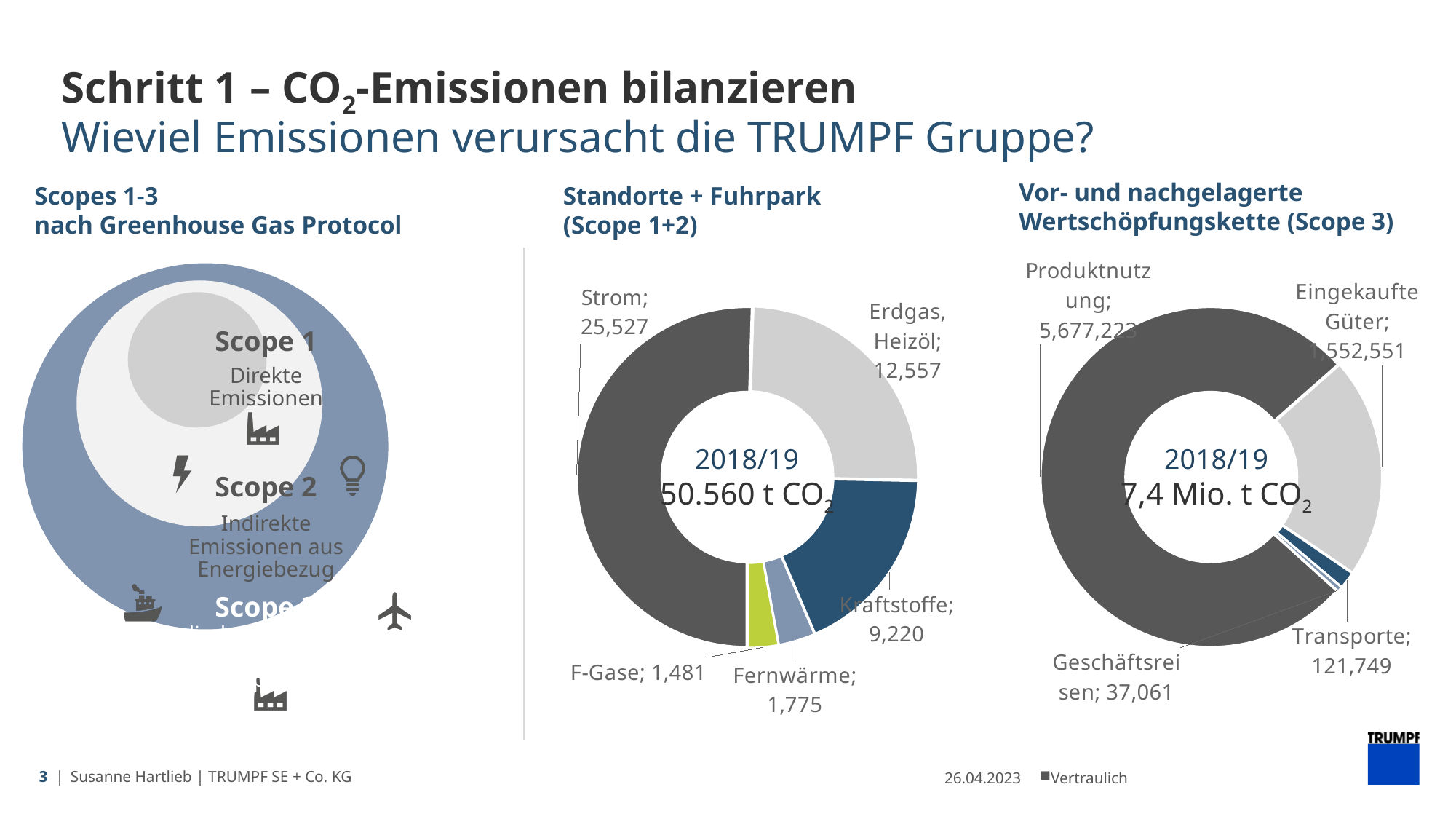
In the Vor- und nachgelagerte Wertschöpfungskette (Scope 3) chart, what is the value for Transporte? 121,749 In the Standorte + Fuhrpark (Scope 1+2) chart, what is the difference between Erdgas, Heizöl and Kraftstoffe? 3,337 In the Standorte + Fuhrpark (Scope 1+2) chart, what is the value for Strom? 25,527 In the Standorte + Fuhrpark (Scope 1+2) chart, what is the value for F-Gase? 1,481 In the Standorte + Fuhrpark (Scope 1+2) chart, what is the value for Kraftstoffe? 9,220 What kind of chart is the Standorte + Fuhrpark (Scope 1+2) chart? Donut (pie) chart How many categories are shown in the Standorte + Fuhrpark (Scope 1+2) chart? 5 In the Standorte + Fuhrpark (Scope 1+2) chart, which category has the largest value? Strom In the Vor- und nachgelagerte Wertschöpfungskette (Scope 3) chart, what is the value for Geschäftsreisen? 37,061 In the Standorte + Fuhrpark (Scope 1+2) chart, which category has the smallest value? F-Gase In the Vor- und nachgelagerte Wertschöpfungskette (Scope 3) chart, which category has the largest value? Produktnutzung In the Vor- und nachgelagerte Wertschöpfungskette (Scope 3) chart, what is the difference between Transporte and Geschäftsreisen? 84,688